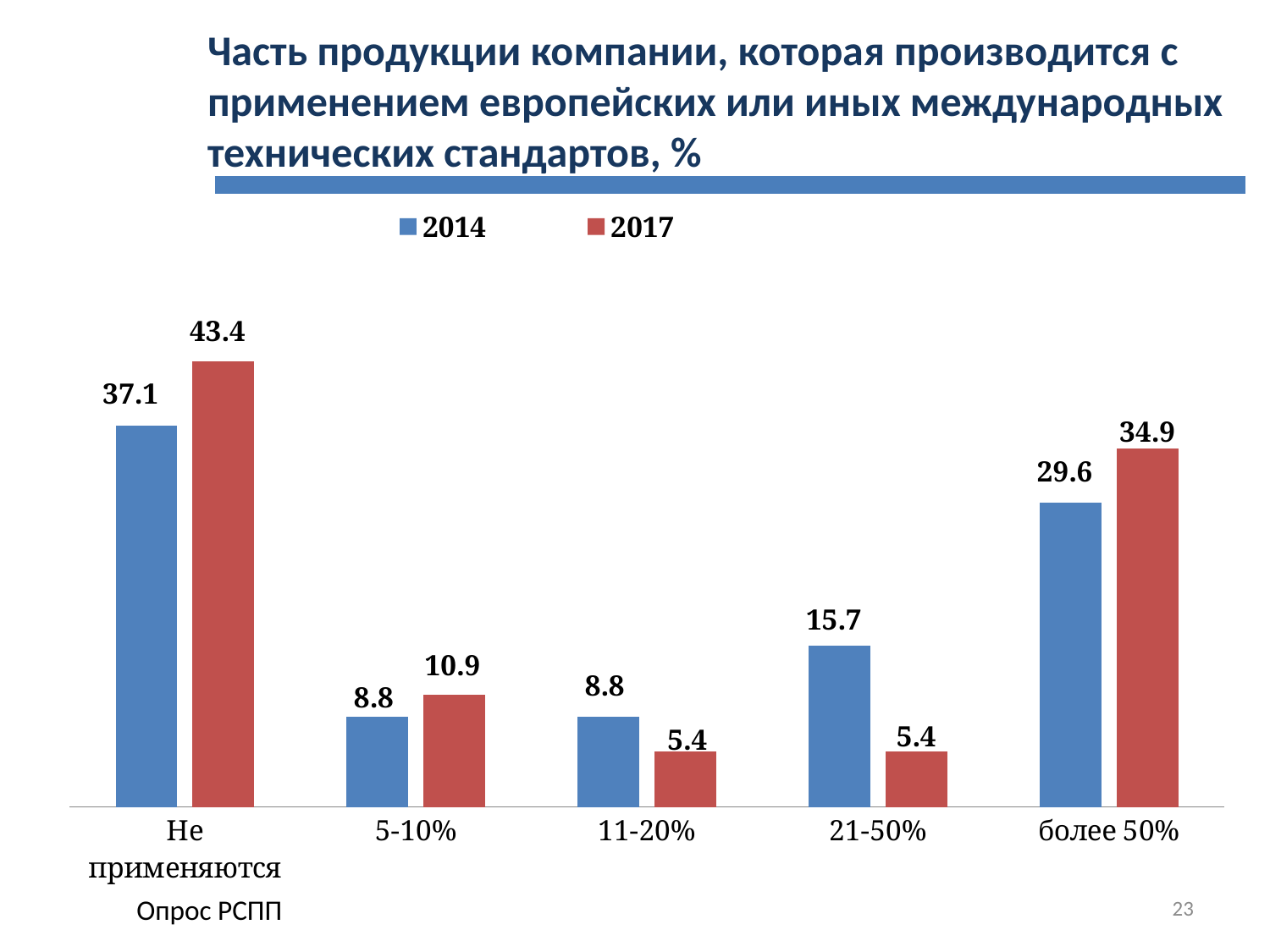
What kind of chart is shown on the slide? Bar chart What is the difference between the 2014 and 2017 values for "21-50%"? 10.3 Which category has the highest 2014 value? Не применяются For the category "5-10%", which year has the larger value, 2014 or 2017? 2017 How many series does the legend list? 2 What is the 2014 value for the category "21-50%"? 15.7 What is the difference between the 2017 and 2014 values for "Не применяются"? 6.3 For the category "11-20%", which year has the larger value, 2014 or 2017? 2014 Which category has the lowest 2014 value? 5-10% and 11-20% (both 8.8) How many categories are shown on the x axis? 5 What is the 2017 value for the category "Не применяются"? 43.4 What is the 2017 value for the category "более 50%"? 34.9